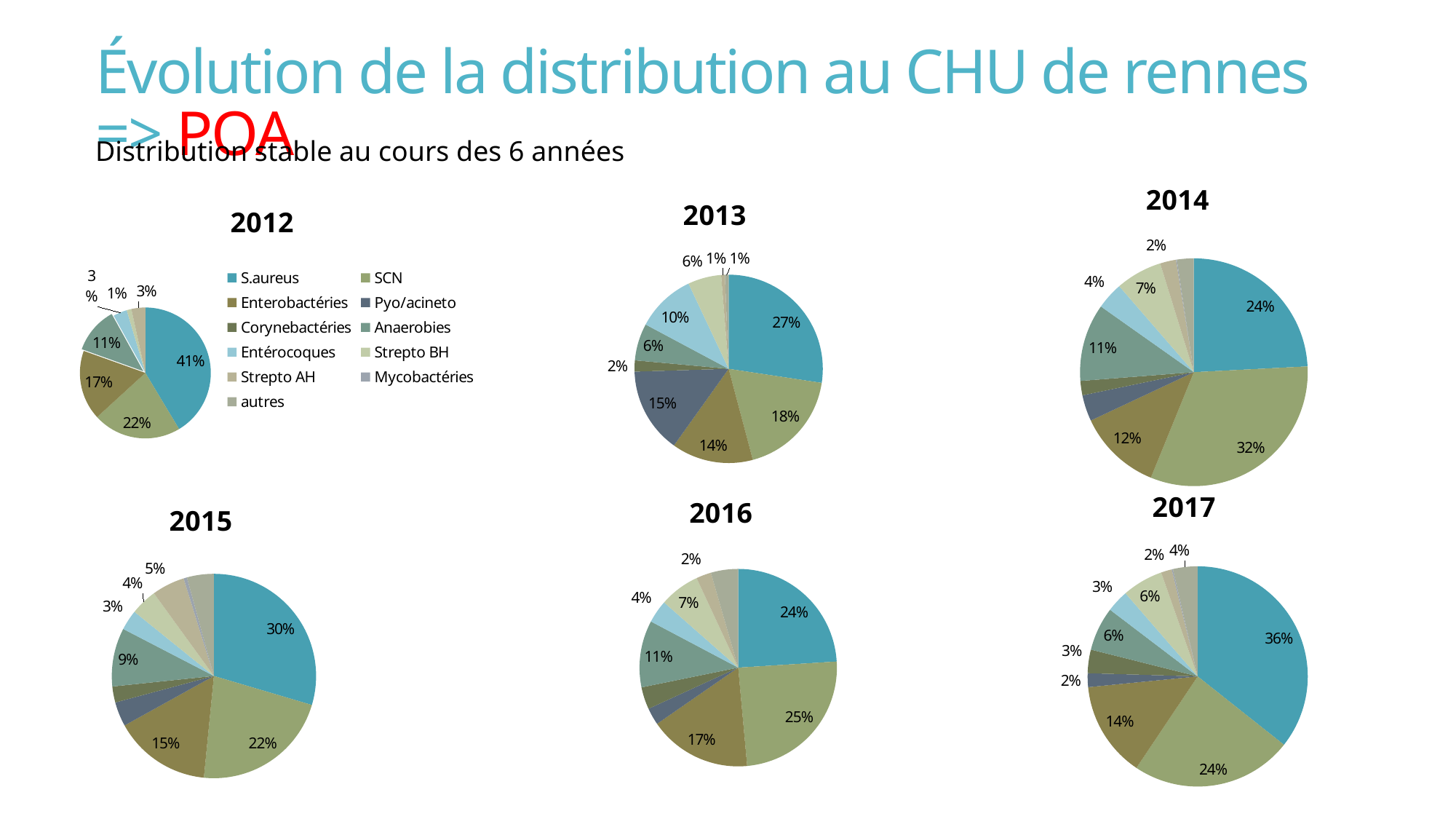
In the 2012 pie chart, what share does S.aureus have? 41% In the 2016 pie chart, what is the difference between the SCN share and the S.aureus share? 1% How many categories does the legend list? 11 In the 2014 pie chart, which is larger, the S.aureus slice or the SCN slice? SCN In the 2017 pie chart, what is the difference between the S.aureus share and the SCN share? 12% What kind of chart is used for each year on the slide? Pie chart In the 2013 pie chart, what share does Pyo/acineto have? 15% How many pie charts are shown on the slide? 6 In the 2015 pie chart, what share does Enterobactéries have? 15% In the 2013 pie chart, what share does Entérocoques have? 10% In the 2017 pie chart, what is the share of S.aureus? 36% In the 2014 pie chart, which category has the largest slice? SCN